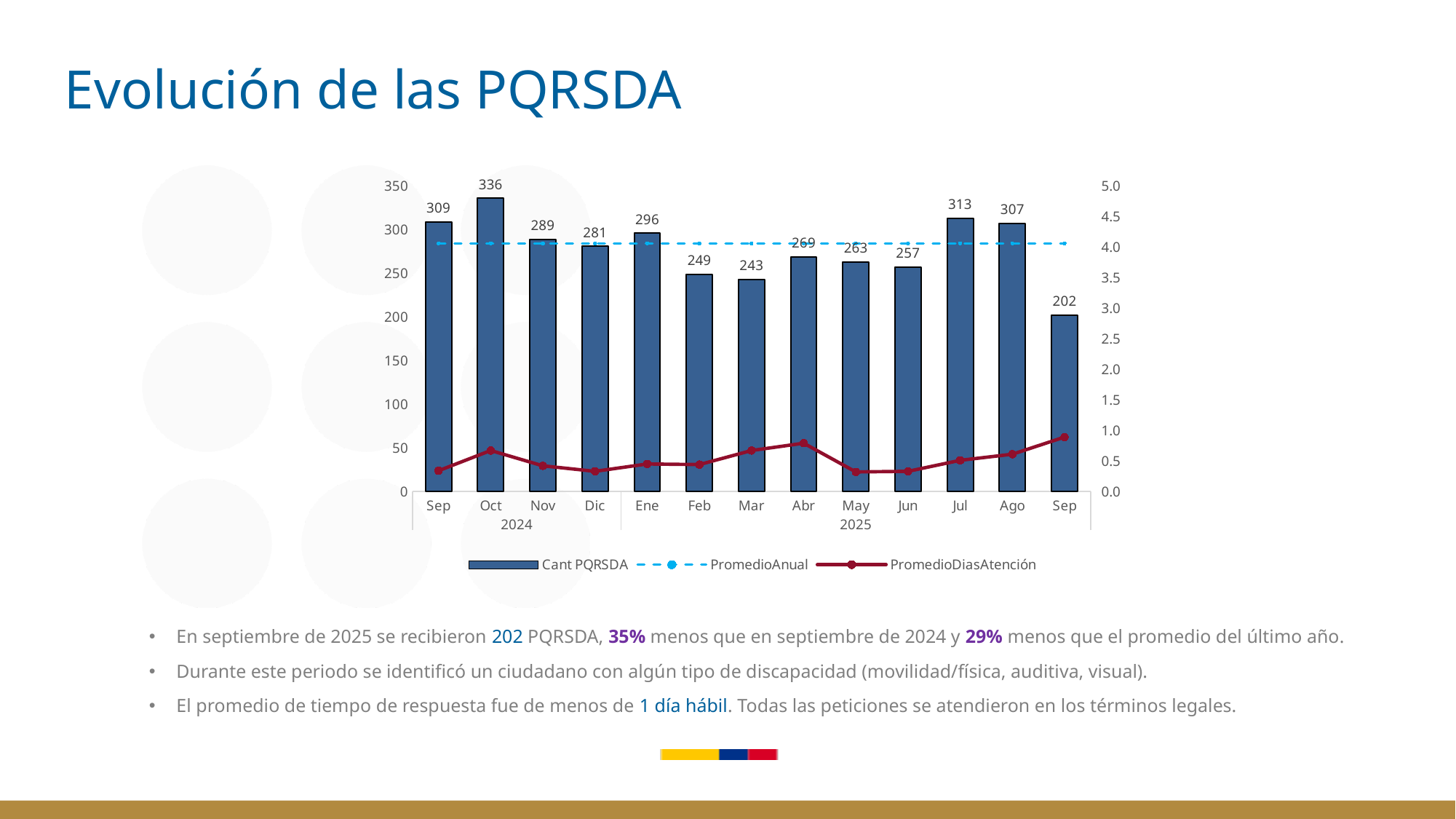
What is the Cant PQRSDA value for Sep 2025? 202 What is the title of the slide containing the chart? Evolución de las PQRSDA Which month has the lowest Cant PQRSDA? Sep 2025 What is the difference between the highest and lowest Cant PQRSDA values? 134 Which month has the highest Cant PQRSDA? Oct 2024 How many months are shown on the x axis? 13 Is the PromedioDiasAtención value for Abr 2025 greater or less than 1.0? less What is the Cant PQRSDA value for Oct 2024? 336 Which has a larger Cant PQRSDA, Jul 2025 or Ago 2025? Jul 2025 What is the difference in Cant PQRSDA between Sep 2024 and Sep 2025? 107 What is the Cant PQRSDA value for Mar 2025? 243 How many series does the legend list? 3